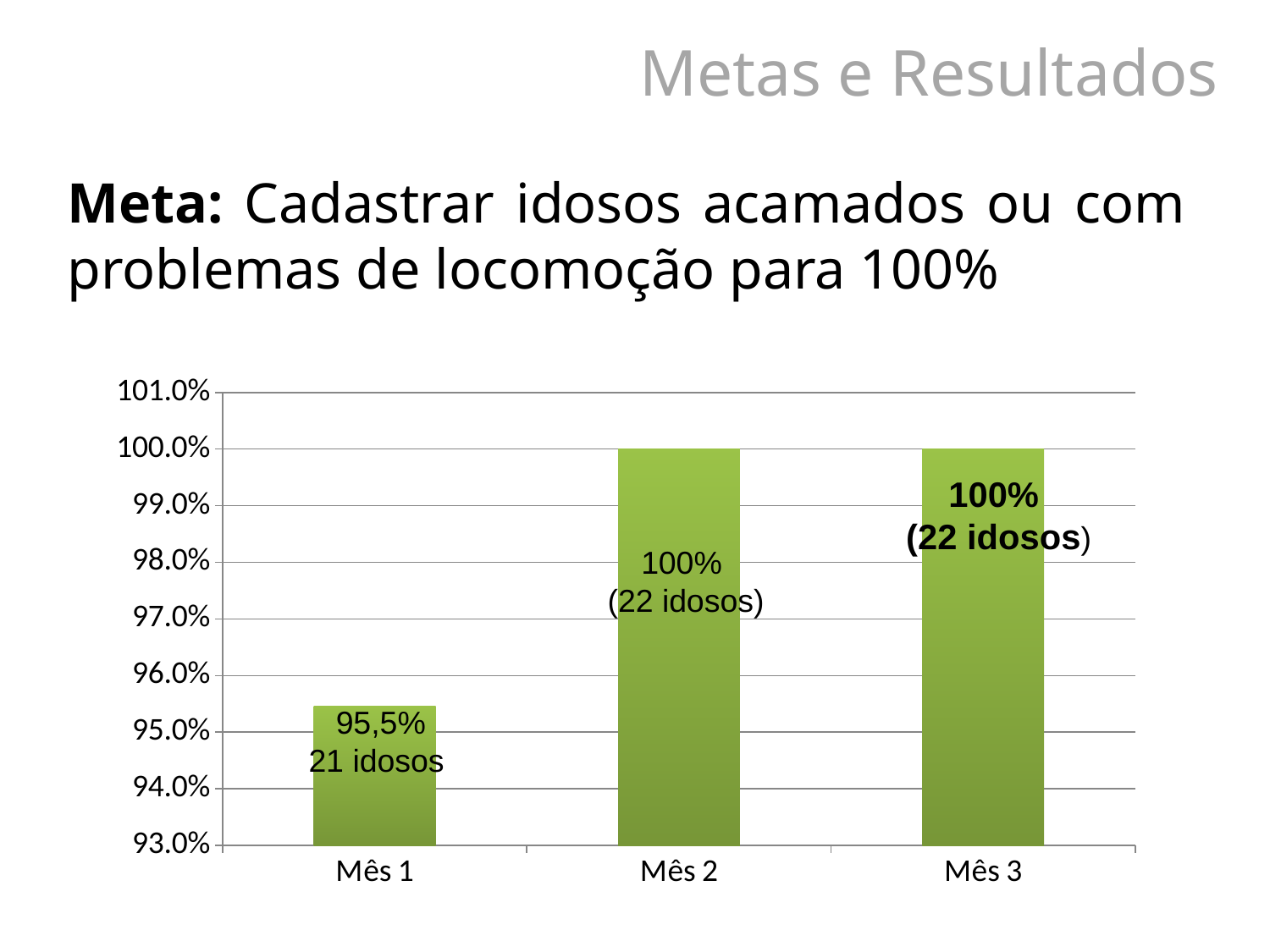
Is the value for Mês 3 greater or less than 99.0%? greater What is the lowest value shown on the y axis? 93.0% Is the value for Mês 1 greater or less than 96.0%? less Do the values rise or fall from Mês 1 to Mês 2? rise Which is larger, the value for Mês 1 or the value for Mês 2? Mês 2 How many months (categories) are shown on the x axis? 3 How many idosos are indicated for Mês 3? 22 idosos What is the value shown for Mês 2? 100% What is the value shown for Mês 1? 95,5% What kind of chart is shown on the slide? bar chart How many idosos are indicated for Mês 1? 21 idosos Which month has the lowest value? Mês 1